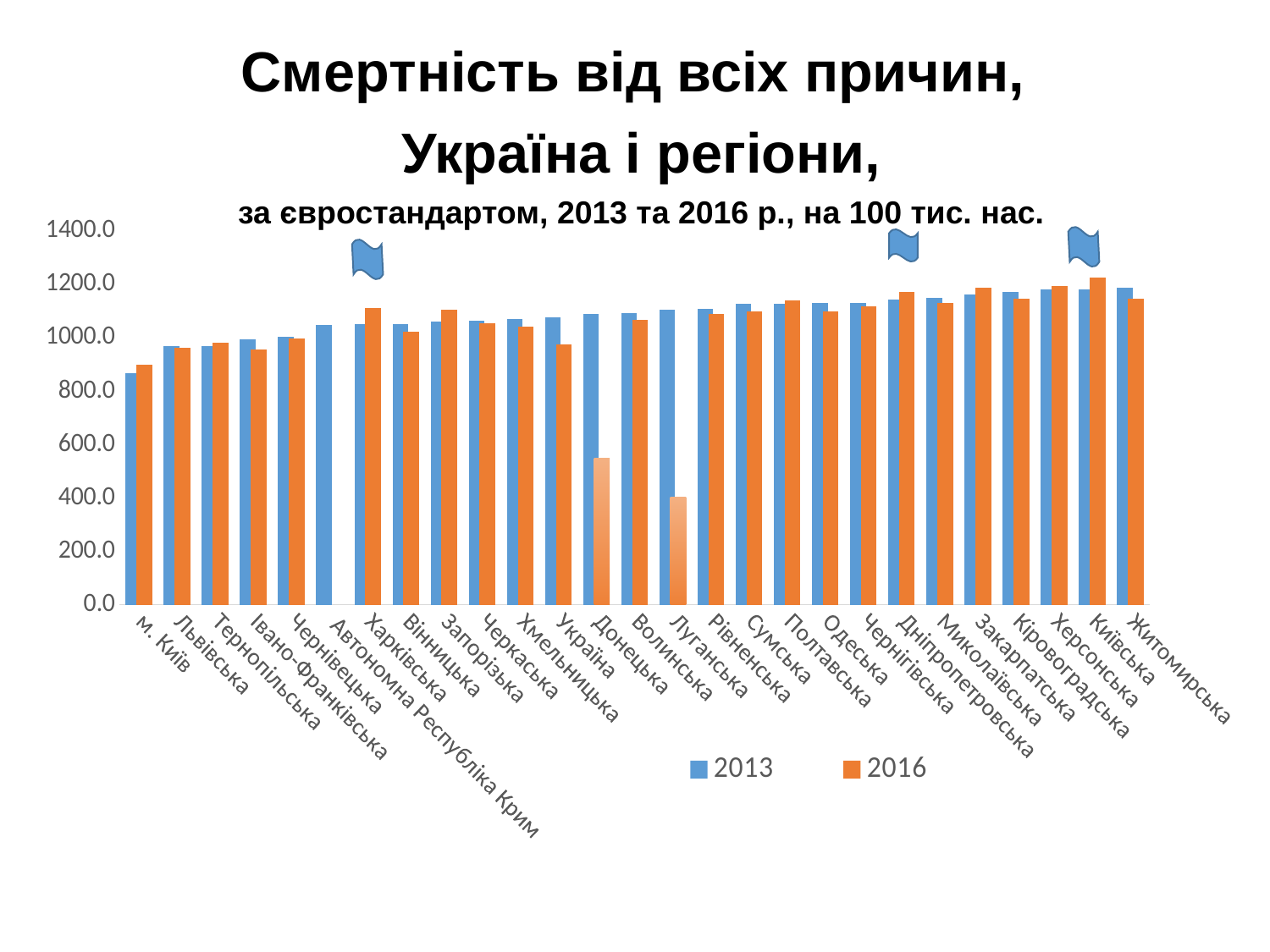
Is the 2013 value for м. Київ greater or less than 1000? less Which category has the highest 2016 value? Київська How many categories are shown along the x axis? 27 Is the 2016 value for Київська greater or less than 1200? greater Which category has the lowest 2016 value? Луганська For Харківська, which is larger: the 2013 value or the 2016 value? 2016 What kind of chart is shown on the slide? bar chart How many series does the legend list? 2 Which category has the lowest 2013 value? м. Київ For Донецька, which is larger: the 2013 value or the 2016 value? 2013 Is the 2016 value for Донецька greater or less than 600? less Do the 2013 values generally rise or fall from left to right along the x axis? rise